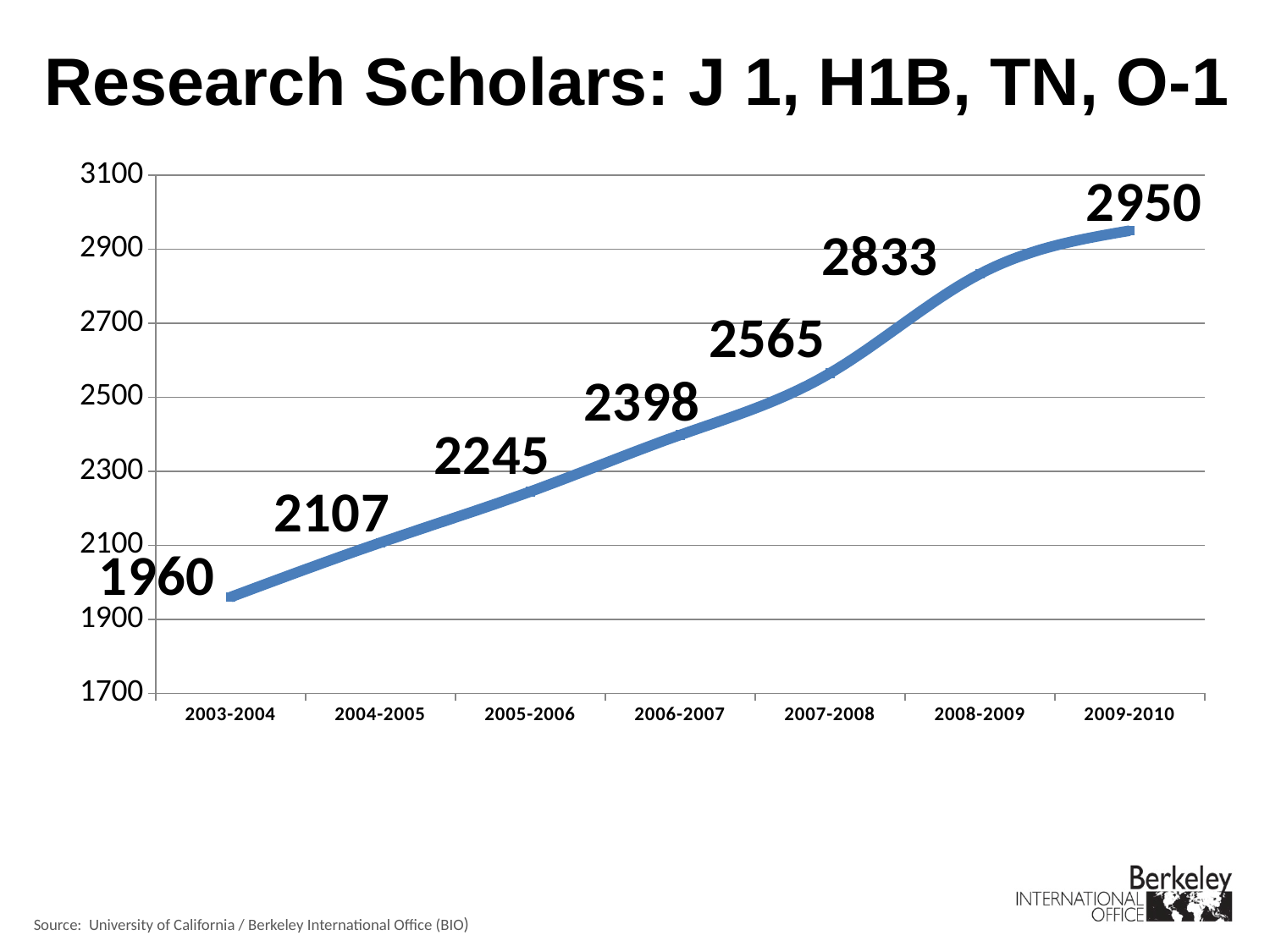
Do the values rise or fall from 2003-2004 to 2009-2010? rise What is the value for 2009-2010? 2950 Which is larger, the value for 2005-2006 or the value for 2004-2005? 2005-2006 Which year has the highest value? 2009-2010 What is the difference between the values for 2009-2010 and 2003-2004? 990 What kind of chart is shown on the slide? line chart What is the difference between the values for 2008-2009 and 2007-2008? 268 Is the value for 2007-2008 greater or less than 2500? greater Which year has the lowest value? 2003-2004 How many years are plotted on the chart? 7 What is the value for 2003-2004? 1960 What is the value for 2006-2007? 2398